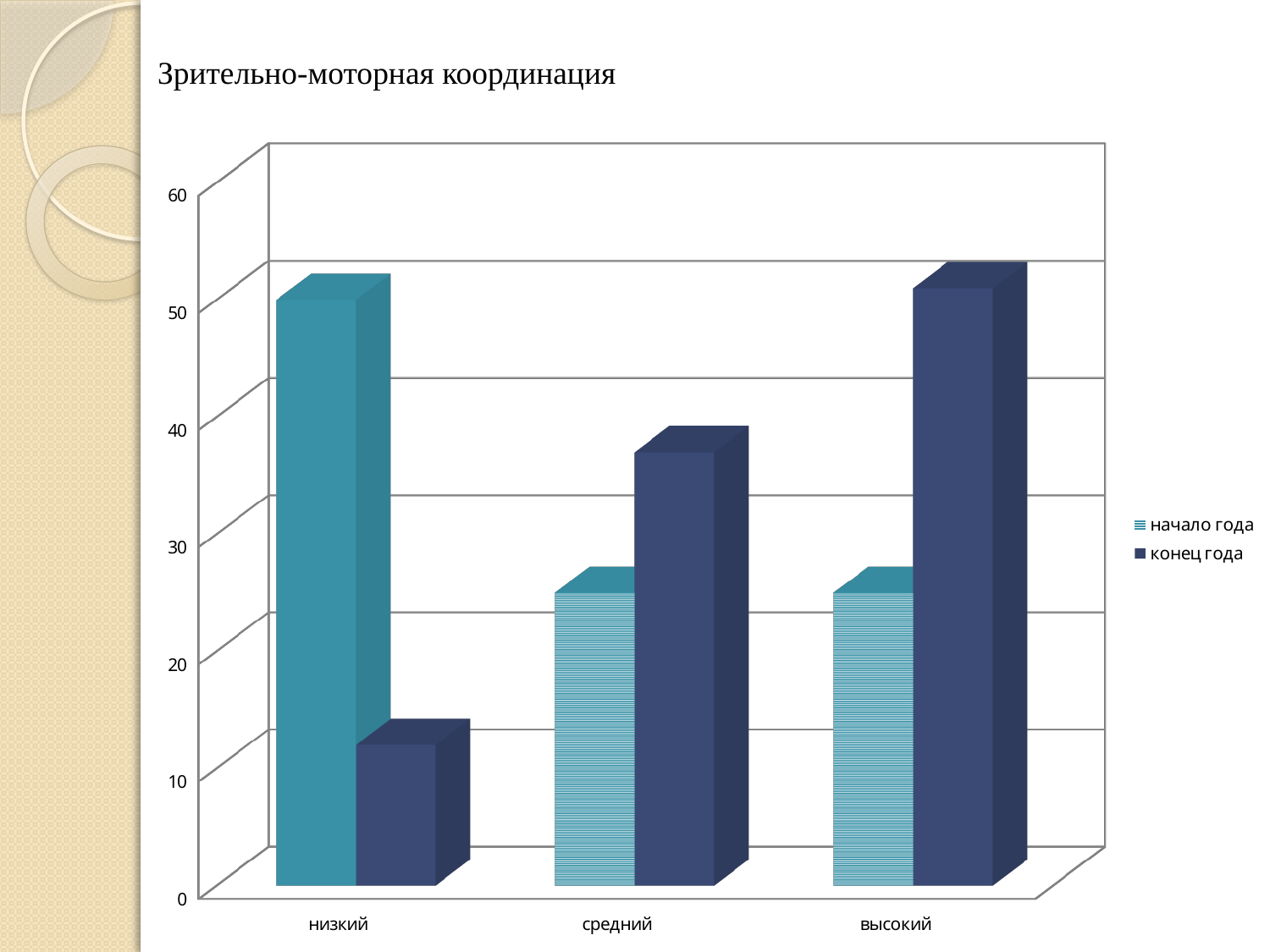
Which category has the lowest value for the series 'конец года'? низкий What kind of chart is shown on the slide? bar chart Which category has the highest value for the series 'начало года'? низкий Which category has the highest value for the series 'конец года'? высокий Is the value for 'низкий' in the series 'конец года' greater or less than 20? less For the category 'высокий', which series has the larger value: 'начало года' or 'конец года'? конец года How many categories are shown on the x axis? 3 Is the value for 'средний' in the series 'конец года' greater or less than 30? greater For the category 'низкий', which series has the larger value: 'начало года' or 'конец года'? начало года What is the title of the chart? Зрительно-моторная координация How many series does the legend list? 2 Is the value for 'низкий' in the series 'начало года' greater or less than 40? greater